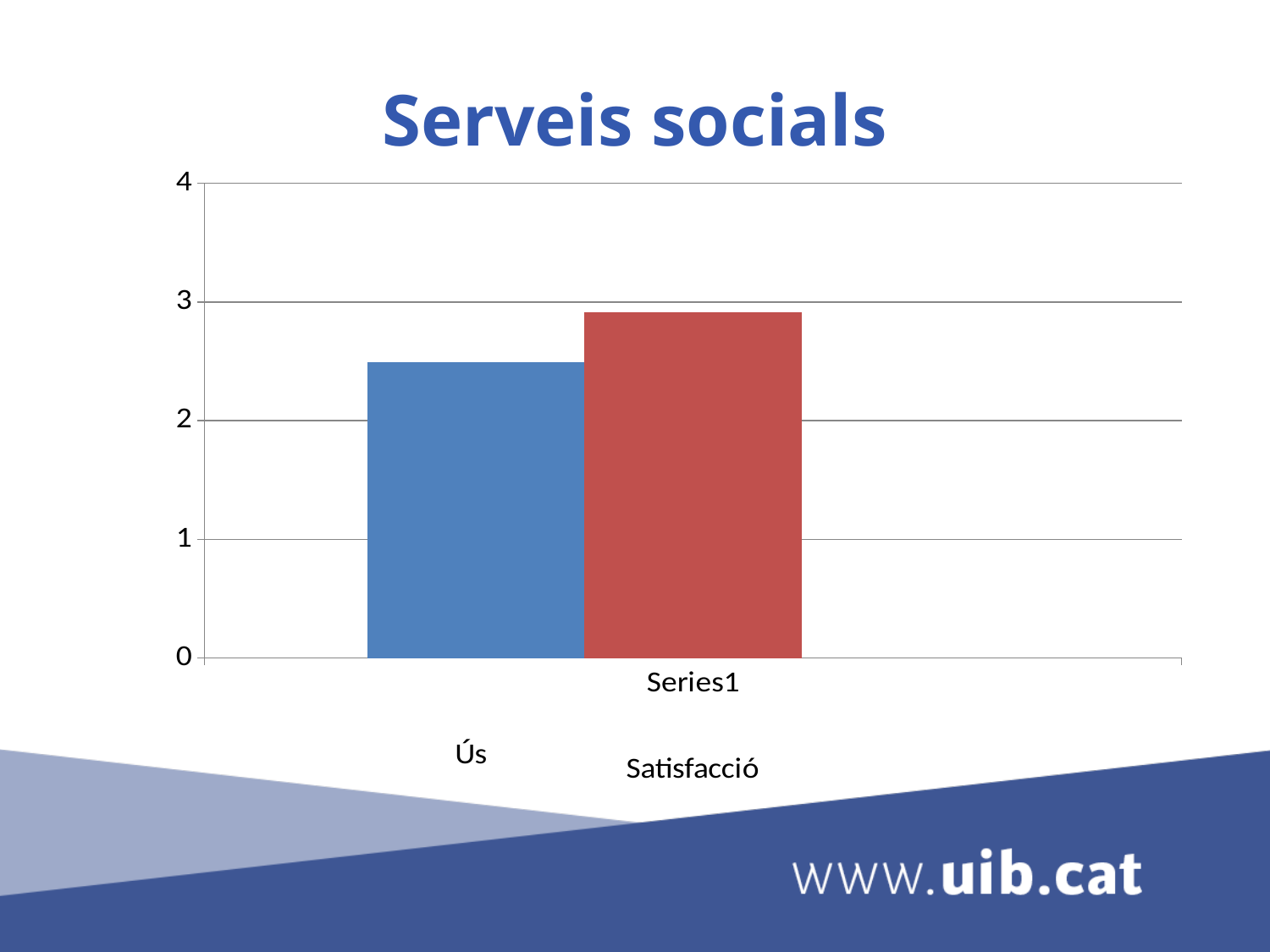
What is the maximum value shown on the vertical axis? 4 Is the value for Satisfacció greater or less than 2? greater Is the value for Satisfacció greater or less than 3? less Which series has the lowest bar? Ús What is the title of the chart? Serveis socials What is the label of the category on the x axis? Series1 Which series is higher, Ús or Satisfacció? Satisfacció Is the value for Ús greater or less than 3? less What kind of chart is shown on the slide? bar chart How many series does the legend list? 2 Which series has the highest bar? Satisfacció